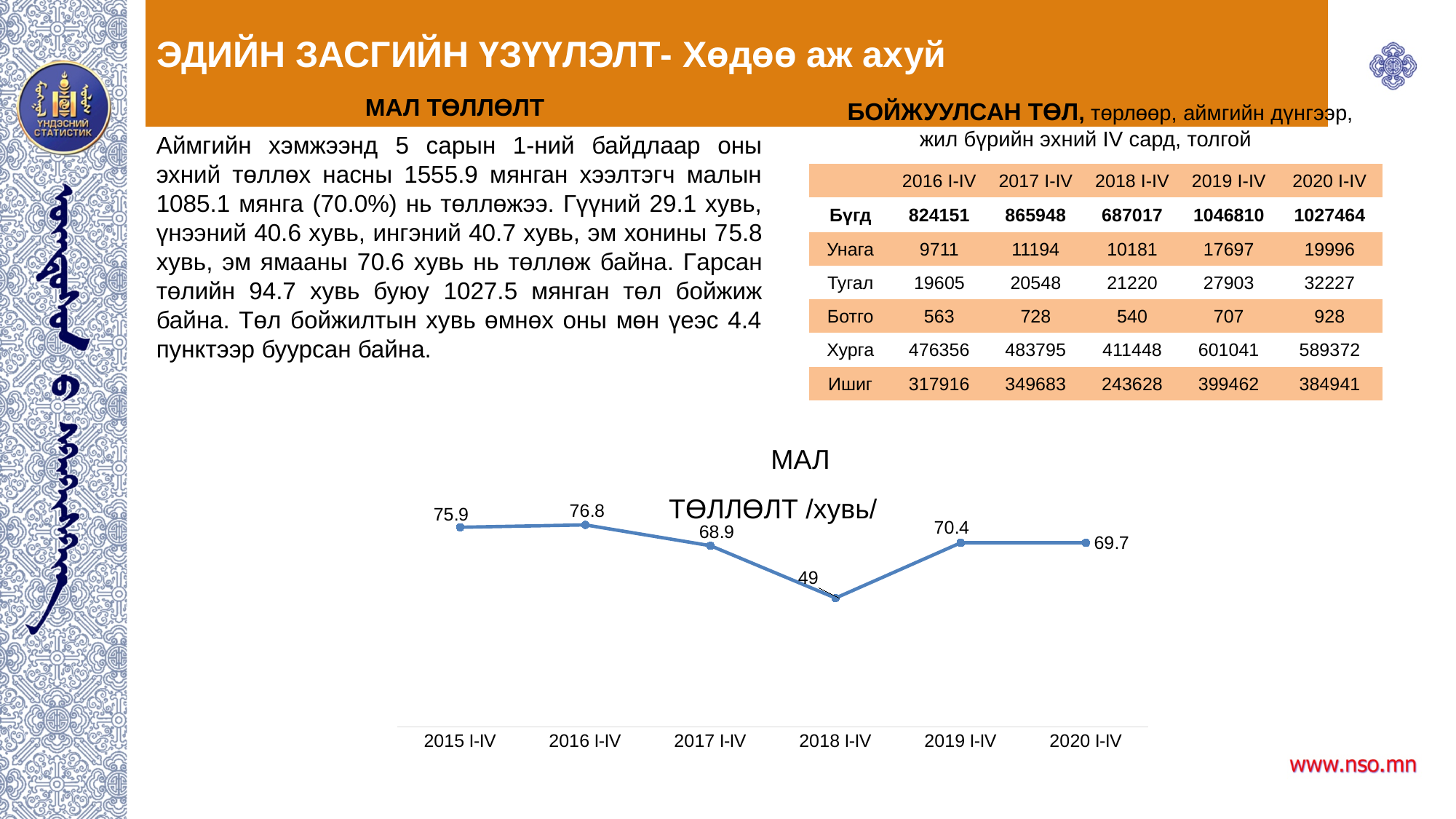
What type of chart is shown on the slide? line chart Which period has the lowest value in the МАЛ ТӨЛЛӨЛТ /хувь/ chart? 2018 I-IV What is the difference between the values for 2019 I-IV and 2018 I-IV in the МАЛ ТӨЛЛӨЛТ /хувь/ chart? 21.4 What is the value for 2018 I-IV in the МАЛ ТӨЛЛӨЛТ /хувь/ chart? 49 Which is larger in the МАЛ ТӨЛЛӨЛТ /хувь/ chart, the value for 2019 I-IV or 2020 I-IV? 2019 I-IV What is the value for 2020 I-IV in the МАЛ ТӨЛЛӨЛТ /хувь/ chart? 69.7 Which period has the highest value in the МАЛ ТӨЛЛӨЛТ /хувь/ chart? 2016 I-IV What is the difference between the values for 2016 I-IV and 2017 I-IV in the МАЛ ТӨЛЛӨЛТ /хувь/ chart? 7.9 Does the value in the МАЛ ТӨЛЛӨЛТ /хувь/ chart rise or fall from 2017 I-IV to 2018 I-IV? fall What is the value for 2015 I-IV in the МАЛ ТӨЛЛӨЛТ /хувь/ chart? 75.9 What is the title of the line chart on the slide? МАЛ ТӨЛЛӨЛТ /хувь/ How many periods are plotted on the x axis of the МАЛ ТӨЛЛӨЛТ /хувь/ chart? 6